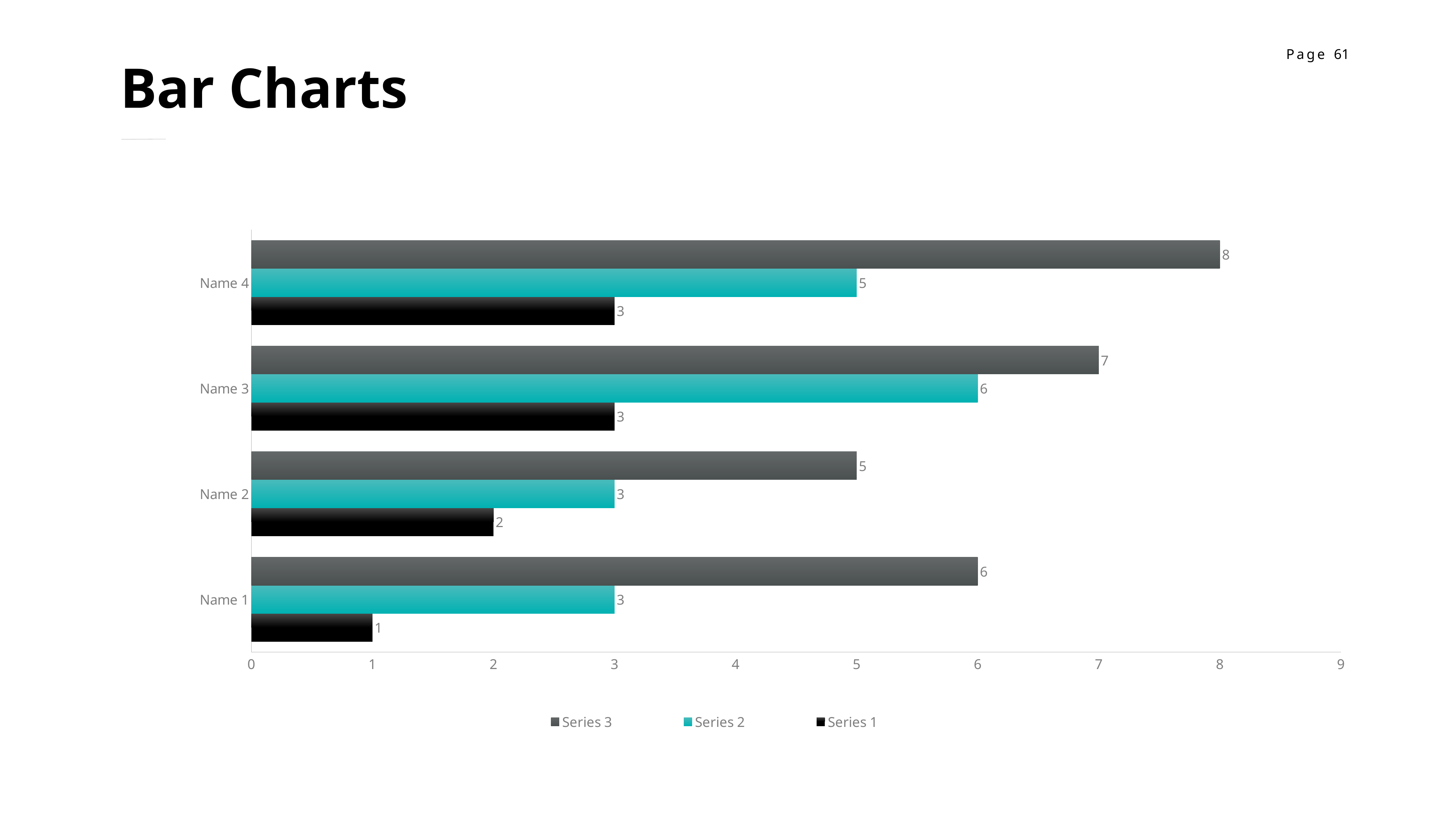
What is the value of Series 1 for Name 1? 1 Which is larger for Name 2: the Series 3 value or the Series 2 value? Series 3 Which category has the lowest Series 1 value? Name 1 What is the title of the slide? Bar Charts What kind of chart is shown on the slide? Bar chart Do the Series 1 values rise or fall going from Name 1 to Name 4? Rise How many categories are shown on the chart? 4 Which category has the highest Series 3 value? Name 4 What is the value of Series 2 for Name 3? 6 What is the value of Series 3 for Name 4? 8 How many series does the legend list? 3 What is the difference between the Series 3 and Series 1 values for Name 4? 5